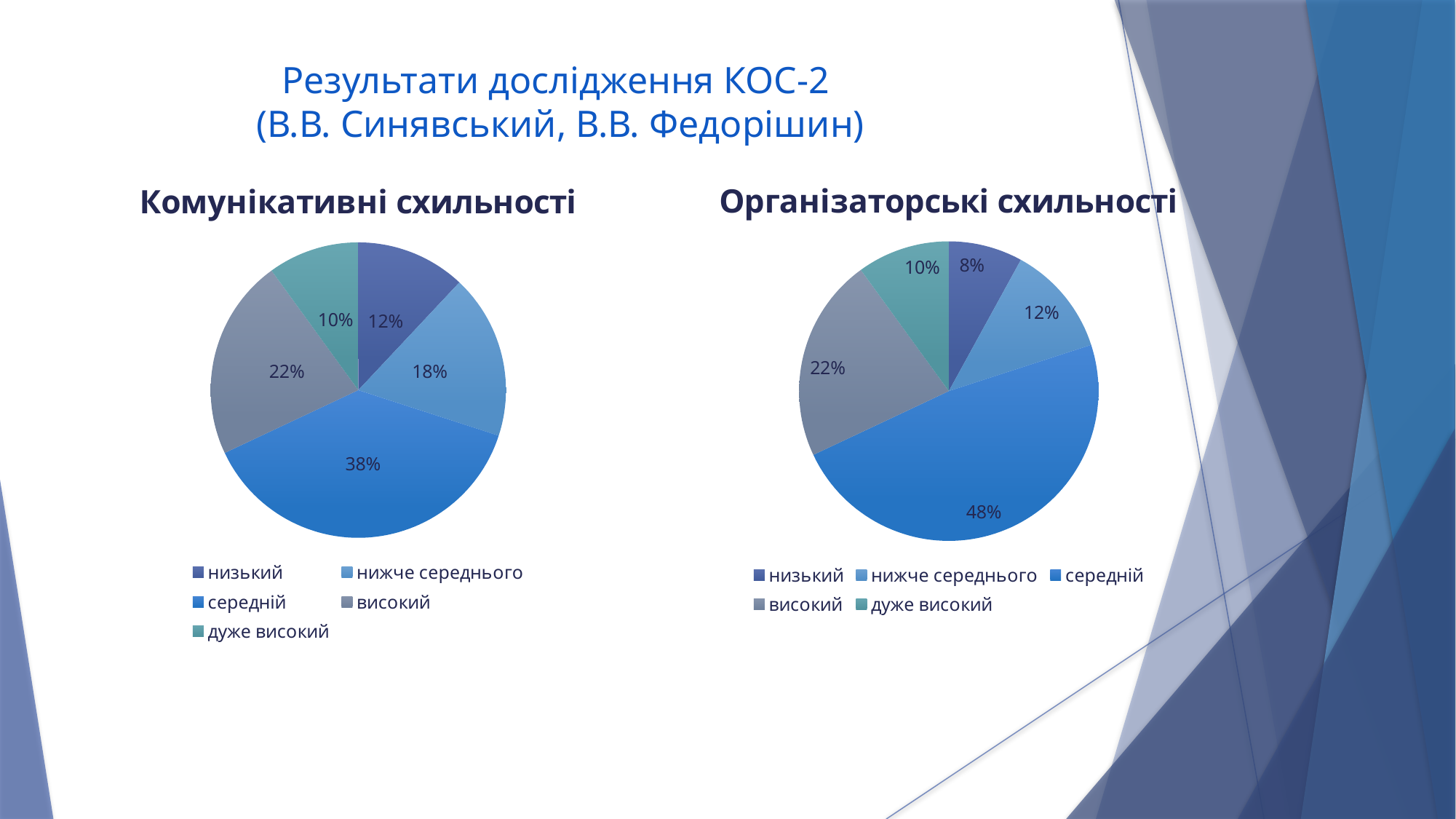
In the "Комунікативні схильності" chart, which category has the smallest slice? дуже високий In the "Організаторські схильності" chart, which category has the largest slice? середній How many slices does the "Комунікативні схильності" pie chart have? 5 In the "Організаторські схильності" chart, what share is labelled for the "низький" slice? 8% What type of chart is used for "Організаторські схильності"? Pie chart In the "Комунікативні схильності" chart, what share is labelled for the "високий" slice? 22% In the "Організаторські схильності" chart, which category has the smallest slice? низький Which is larger: the "низький" share in the "Комунікативні схильності" chart or the "низький" share in the "Організаторські схильності" chart? Комунікативні схильності What is the difference between the "середній" share in the "Організаторські схильності" chart and the "середній" share in the "Комунікативні схильності" chart? 10% In the "Організаторські схильності" chart, what share is labelled for the "нижче середнього" slice? 12% In the "Комунікативні схильності" chart, what share is labelled for the "середній" slice? 38% In the "Комунікативні схильності" chart, what is the combined share of the "низький" and "нижче середнього" slices? 30%